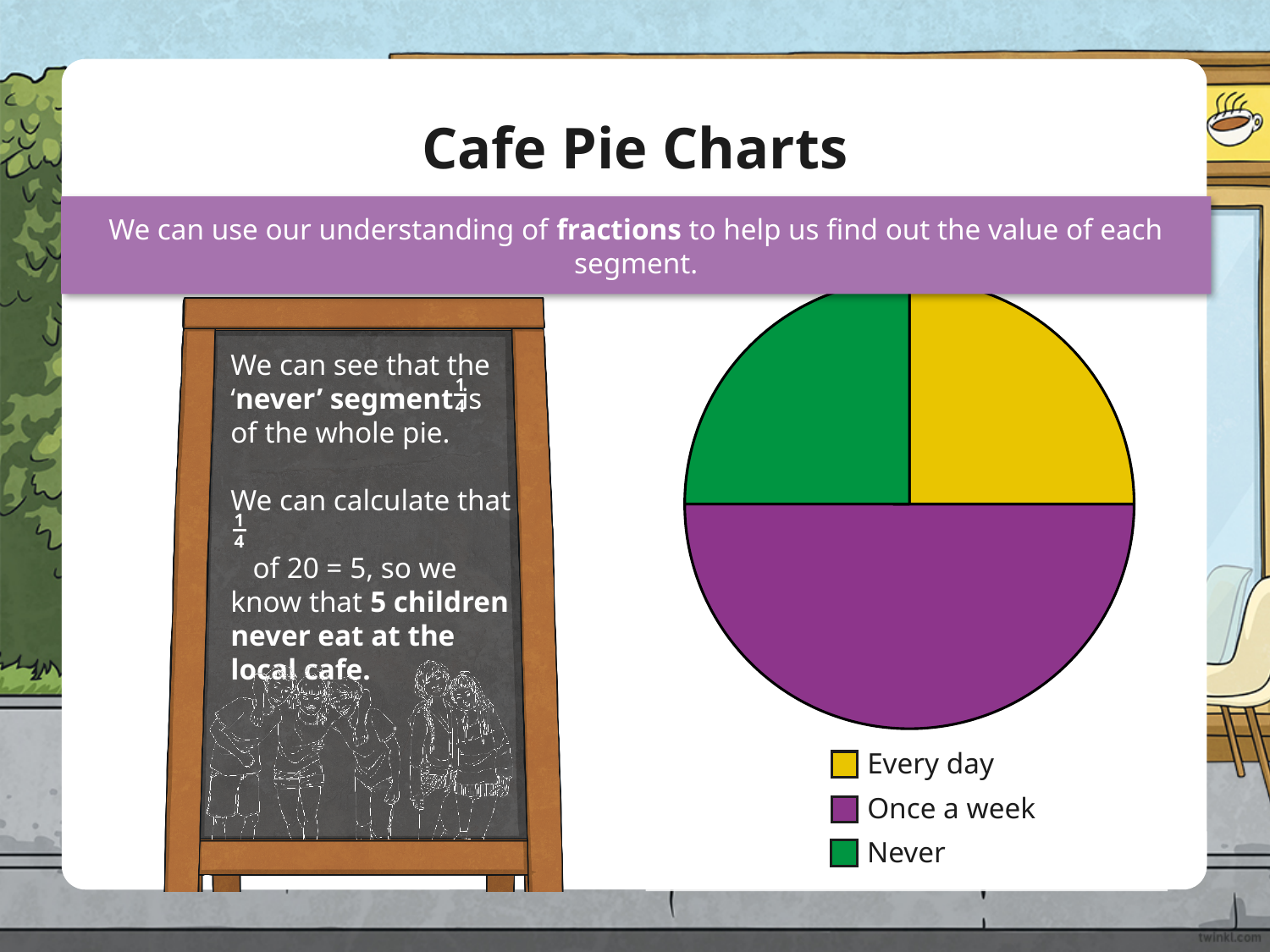
Which is larger in the pie chart, the 'Once a week' segment or the 'Never' segment? Once a week Which legend entry is shown in yellow? Every day What colour is the 'Never' segment in the pie chart? green What fraction of the whole pie is the 'Never' segment? 1/4 What kind of chart is shown on the slide? pie chart According to the slide, how many children never eat at the local cafe? 5 children According to the slide, how many children in total does the pie chart represent? 20 How many entries does the legend of the pie chart list? 3 Which is larger in the pie chart, the 'Once a week' segment or the 'Every day' segment? Once a week Which segment of the pie chart is the largest? Once a week How many segments does the pie chart have? 3